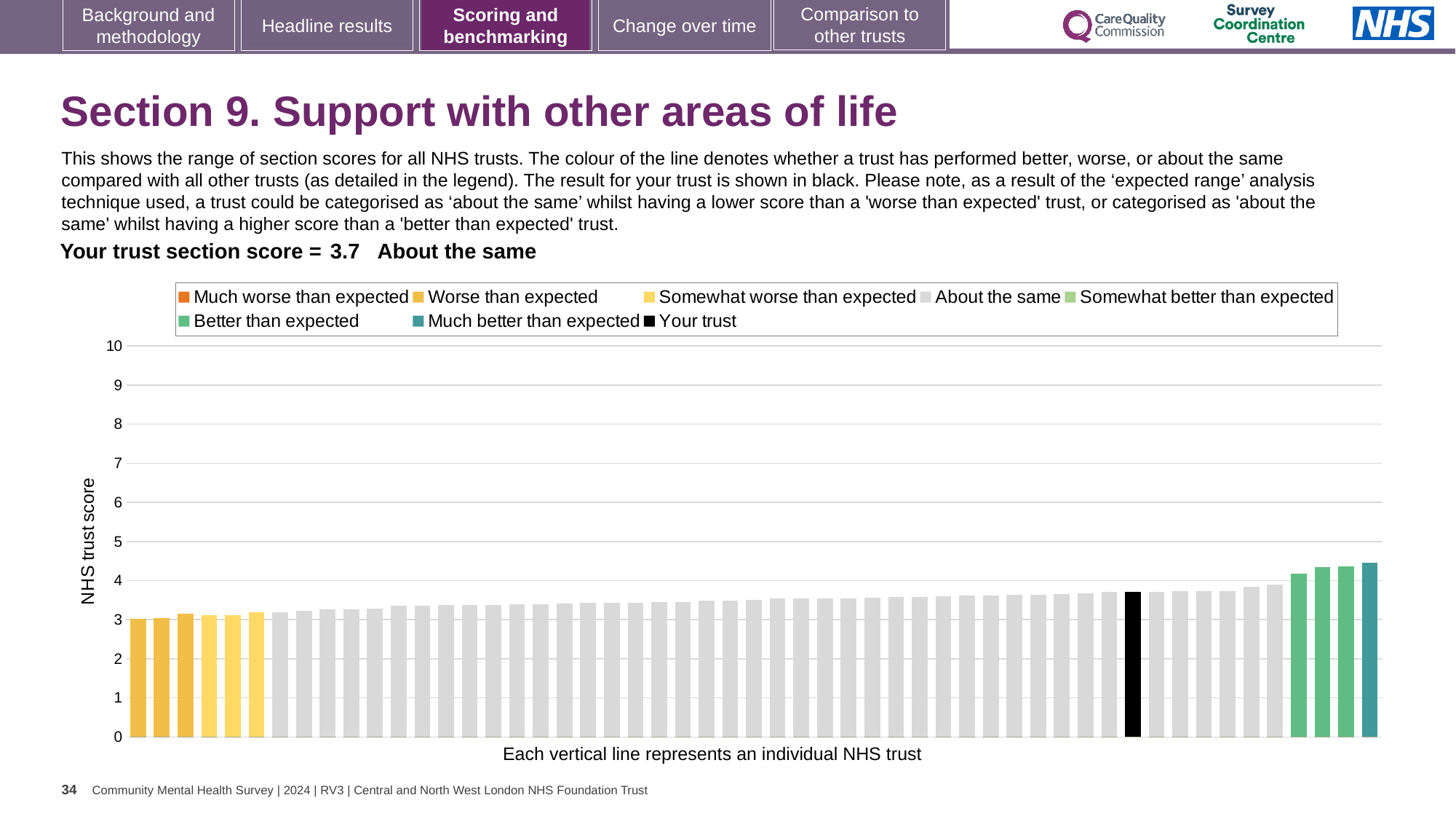
Do the bar values rise or fall from left to right along the x axis? rise How is your trust's section score categorised compared with other trusts? About the same Is the value for your trust (the black bar) greater or less than 3? greater What is the section score for your trust shown on the slide? 3.7 Which is larger: the value for your trust (black bar) or the value of the rightmost teal bar? the rightmost teal bar Is the value of the shortest bar (the leftmost bar) greater or less than 2? greater What is the label on the x axis of the chart? Each vertical line represents an individual NHS trust Is the value for your trust (the black bar) greater or less than 4? less What colour is the bar representing your trust? black What kind of chart is shown on the slide? bar chart How many entries does the chart legend list? 8